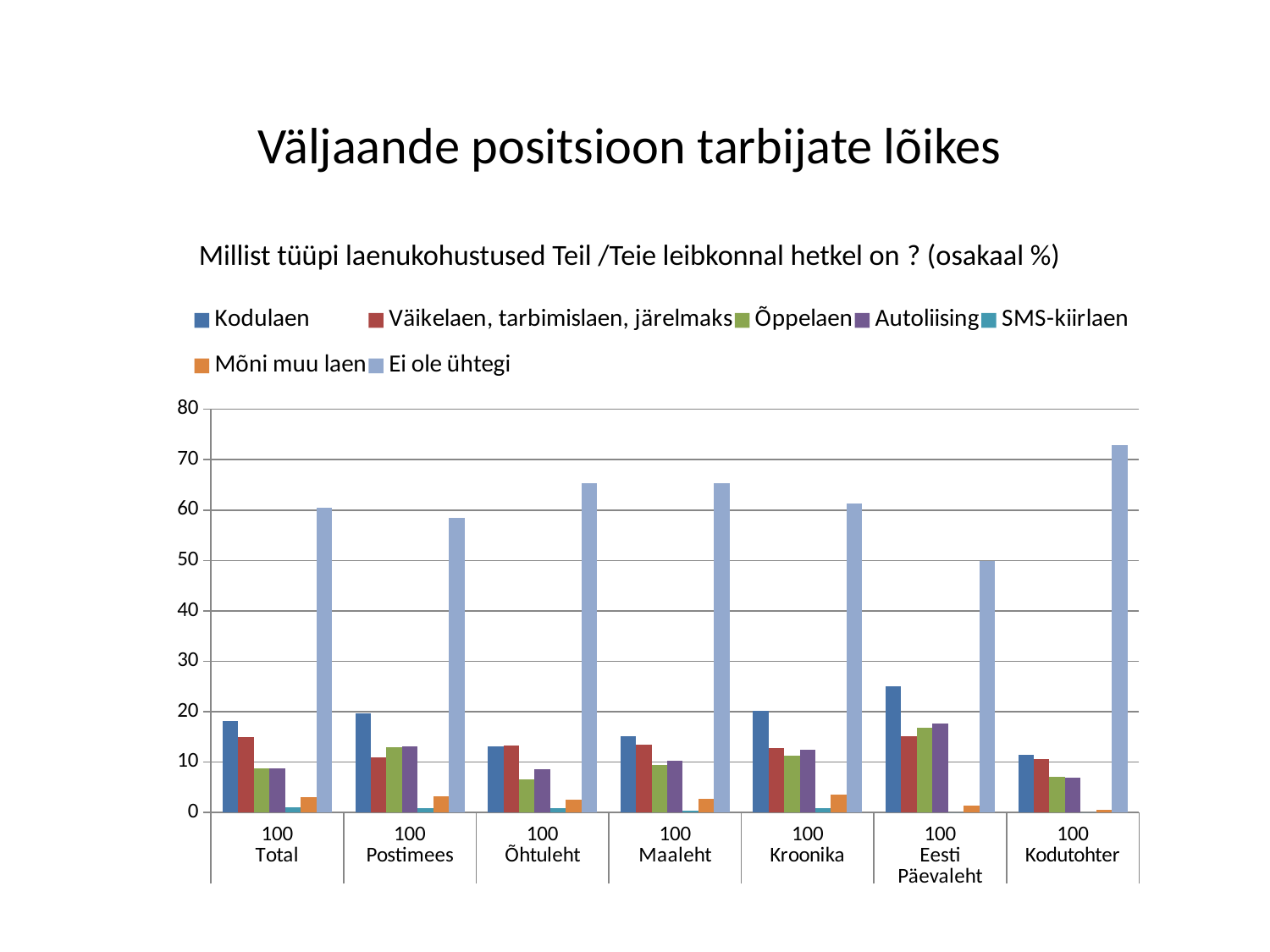
How many series does the legend list? 7 Which category has the highest value for the 'Kodulaen' series? Eesti Päevaleht Which category has the highest value for the 'Ei ole ühtegi' series? Kodutohter Is the 'Ei ole ühtegi' value for Õhtuleht greater or less than 60? greater Is the 'Kodulaen' value for Eesti Päevaleht greater or less than 20? greater Which category has the lowest value for the 'Kodulaen' series? Kodutohter What kind of chart is shown on the slide? bar chart Is the 'Ei ole ühtegi' value for Kodutohter greater or less than 70? greater Which category has the lowest value for the 'Ei ole ühtegi' series? Eesti Päevaleht What is the title of the chart? Millist tüüpi laenukohustused Teil /Teie leibkonnal hetkel on ? (osakaal %) Which is larger: the 'Kodulaen' value for Kroonika or for Õhtuleht? Kroonika How many publication categories are shown along the x axis? 7